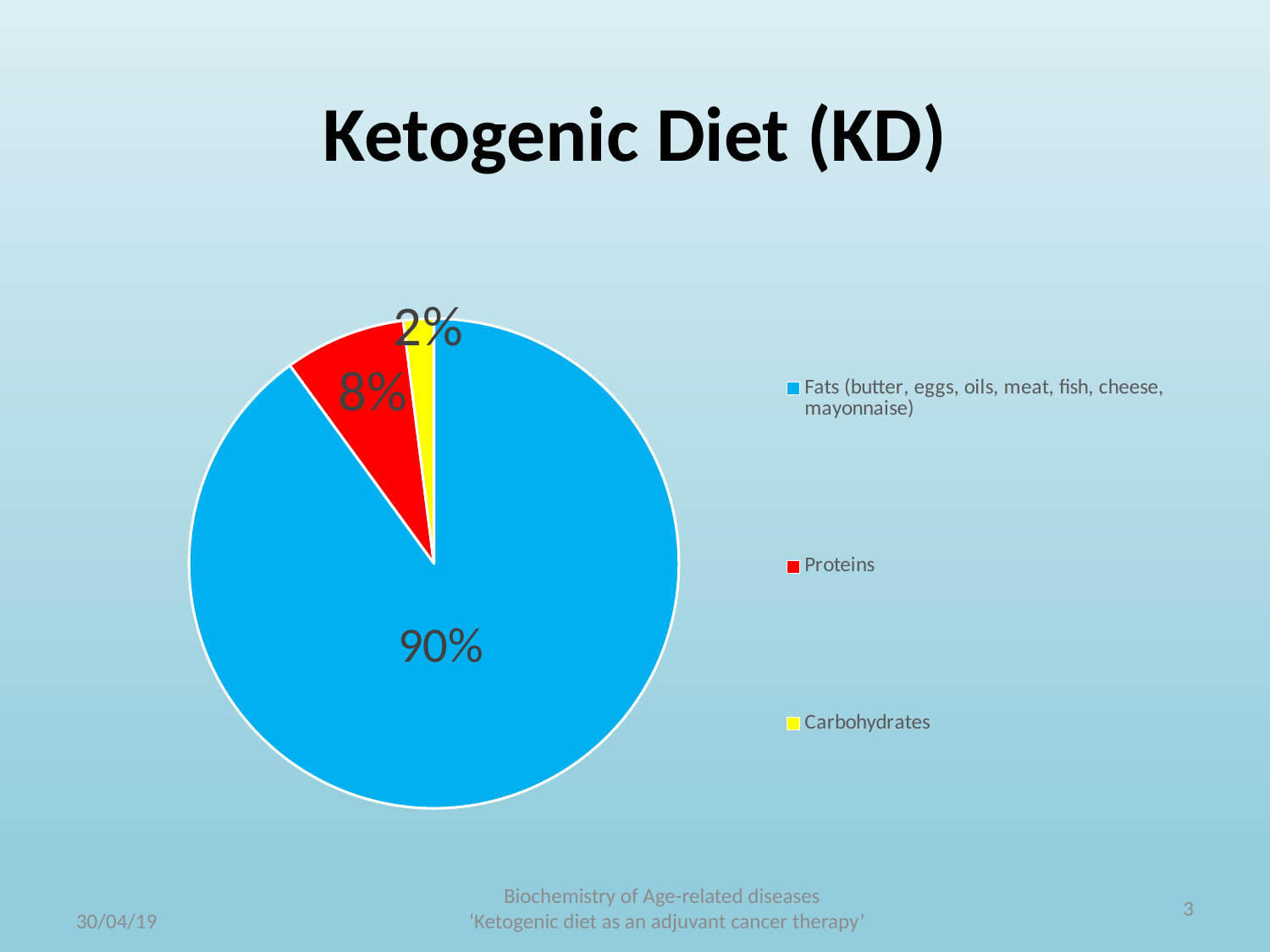
What kind of chart is shown on the slide? pie chart What colour is the Carbohydrates slice? yellow Which category has the largest slice of the pie? Fats (butter, eggs, oils, meat, fish, cheese, mayonnaise) What is the title of the slide containing the pie chart? Ketogenic Diet (KD) What share of the pie does Carbohydrates take? 2% What is the difference in percentage points between the Fats slice and the Proteins slice? 82 Which is larger, the Proteins slice or the Carbohydrates slice? Proteins Which category has the smallest slice of the pie? Carbohydrates What is the difference in percentage points between the Proteins slice and the Carbohydrates slice? 6 What share of the pie does Fats (butter, eggs, oils, meat, fish, cheese, mayonnaise) take? 90% What share of the pie does Proteins take? 8% How many categories does the pie chart show? 3